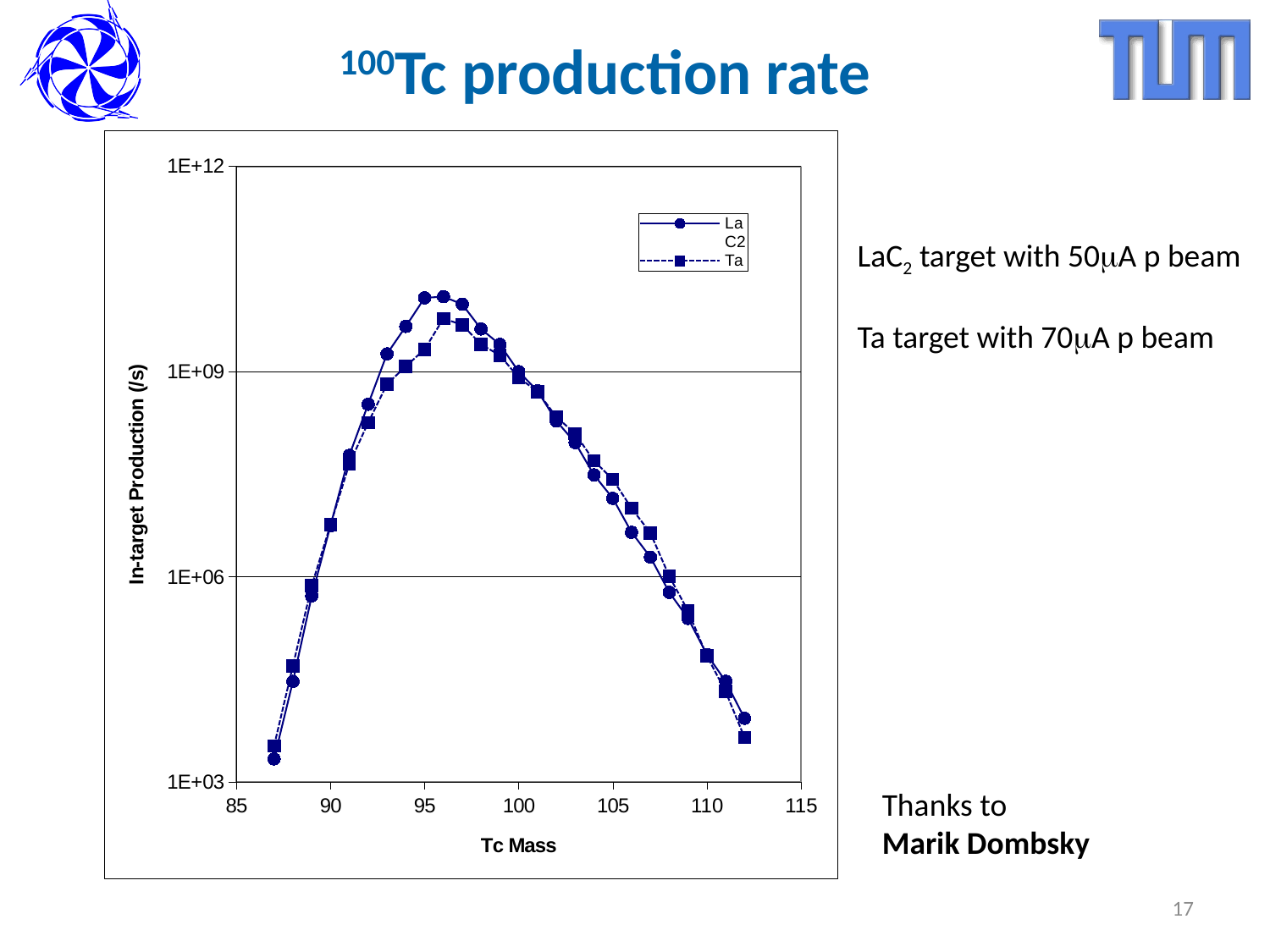
Is the Ta in-target production at Tc mass 110 greater or less than 1E+06? less Is the LaC2 in-target production at Tc mass 87 greater or less than 1E+06? less How many series does the chart legend list? 2 Is the LaC2 in-target production at Tc mass 90 greater or less than 1E+06? greater At Tc mass 96, which series has the higher in-target production, LaC2 or Ta? LaC2 What kind of chart is shown on the slide? line chart At Tc mass 104, which series has the higher in-target production, LaC2 or Ta? Ta At which Tc mass does the Ta series reach its highest in-target production? 96 What are the two series named in the chart legend? LaC2 and Ta What is the label of the chart's x axis? Tc Mass Does the LaC2 in-target production rise or fall as Tc mass increases from 100 to 112? fall